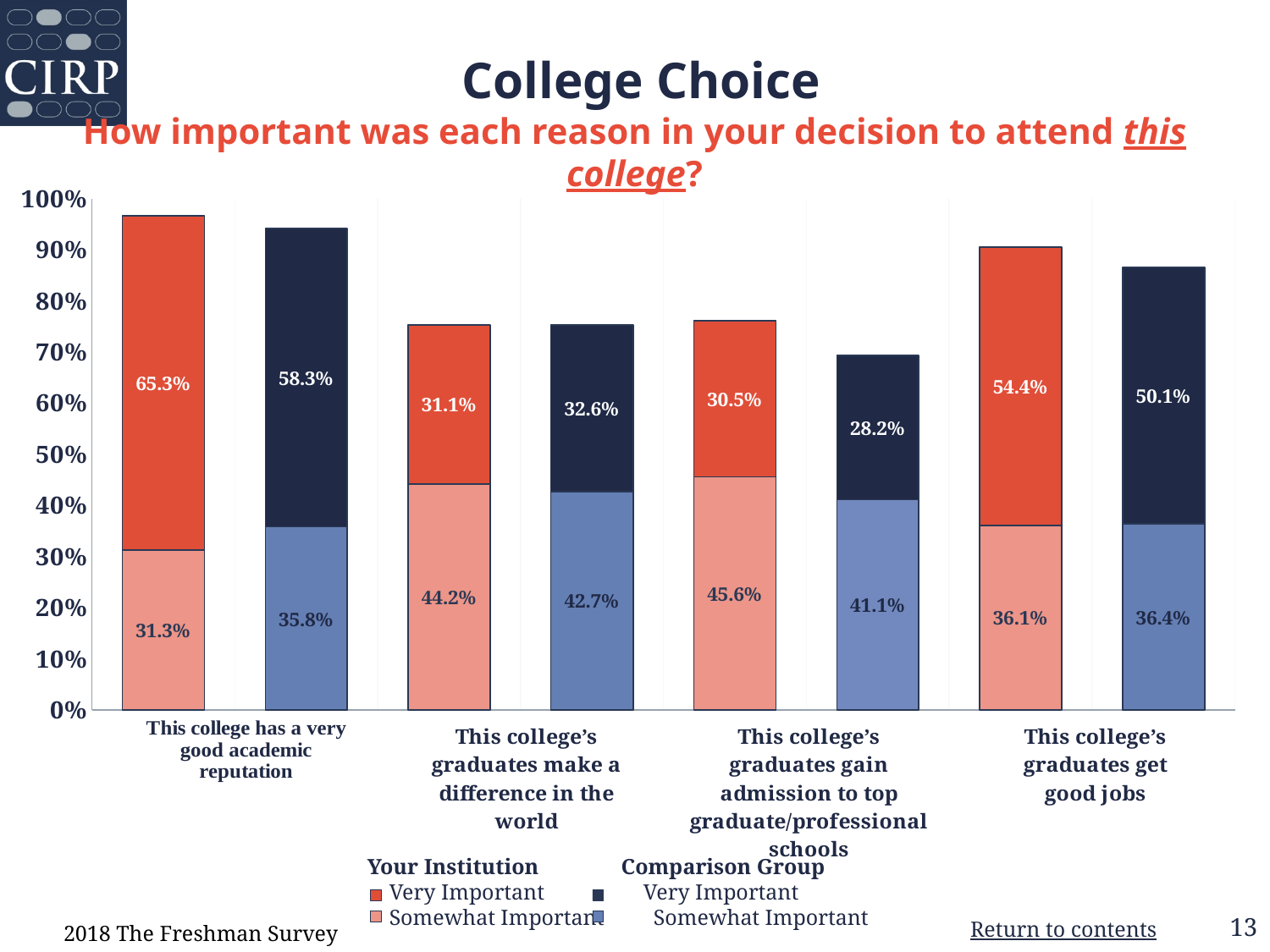
What is the total height of the Your Institution stacked bar for "This college's graduates get good jobs"? 90.5% What percentage of Your Institution respondents rated "This college has a very good academic reputation" as Very Important? 65.3% What is the Comparison Group's Very Important value for "This college's graduates gain admission to top graduate/professional schools"? 28.2% Which reason has the highest Very Important percentage for Your Institution? This college has a very good academic reputation What is the difference between Your Institution's and the Comparison Group's Very Important values for "This college has a very good academic reputation"? 7.0% Which reason has the lowest Very Important percentage for the Comparison Group? This college's graduates gain admission to top graduate/professional schools What kind of chart is shown on the slide? Stacked bar chart What is the total height of the Comparison Group stacked bar for "This college's graduates gain admission to top graduate/professional schools"? 69.3% What percentage of the Comparison Group rated "This college's graduates get good jobs" as Somewhat Important? 36.4% How many reasons (categories) are shown on the x axis of the chart? 4 For "This college's graduates make a difference in the world", which group has the larger Very Important value, Your Institution or the Comparison Group? Comparison Group How many series does the legend list? 4